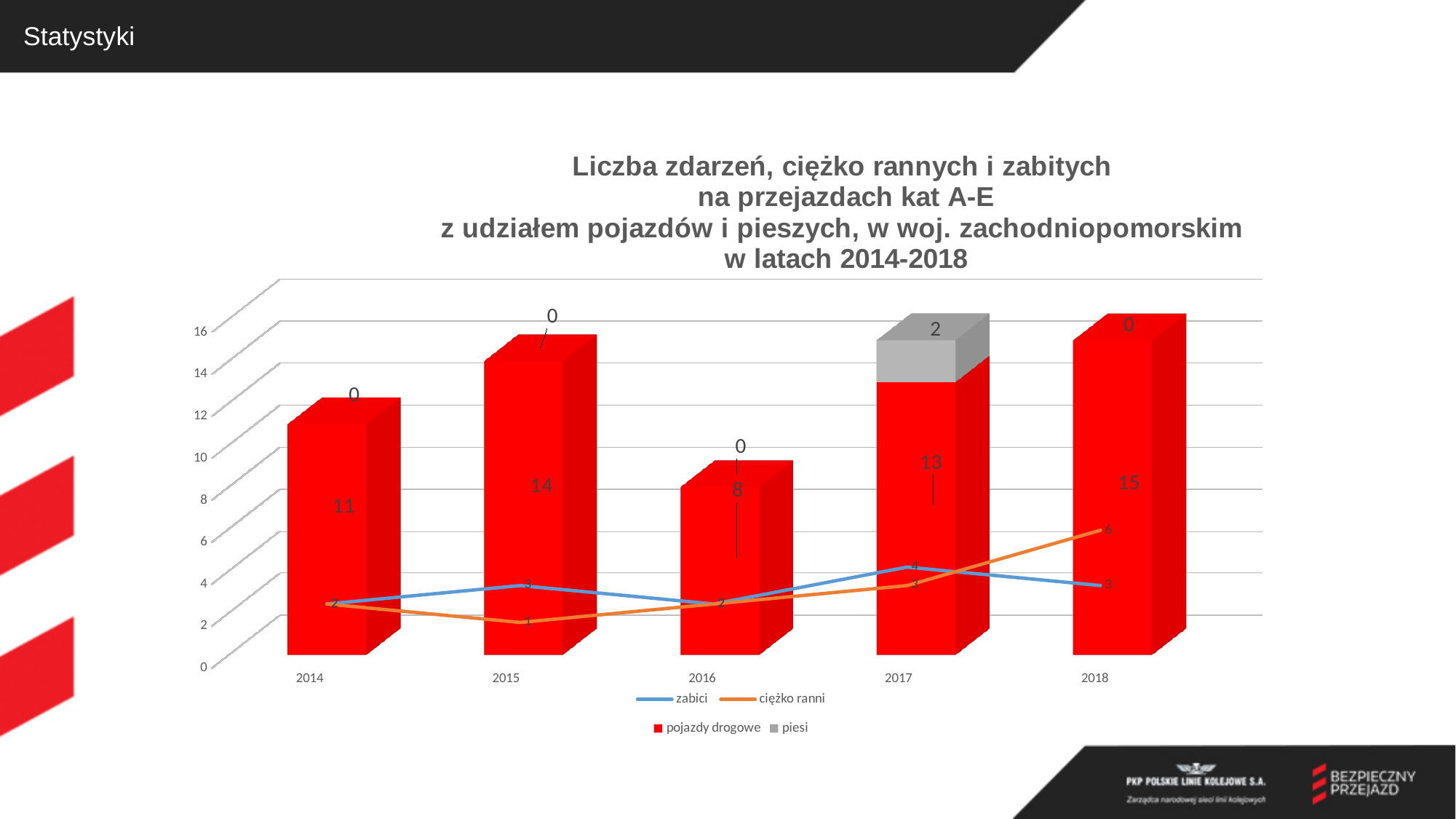
In 2018, which is larger: zabici or ciężko ranni? ciężko ranni What is the value for zabici in 2017? 4 How many years are shown on the x axis? 5 What is the total of the stacked bar for 2017 (pojazdy drogowe plus piesi)? 15 What is the value for ciężko ranni in 2018? 6 What is the value for piesi in 2017? 2 What is the value for pojazdy drogowe in 2015? 14 How many series does the legend list? 4 What is the difference between the pojazdy drogowe values for 2018 and 2016? 7 In which year is the value for pojazdy drogowe the highest? 2018 Does the value for ciężko ranni rise or fall from 2016 to 2018? rise In which year is the value for pojazdy drogowe the lowest? 2016